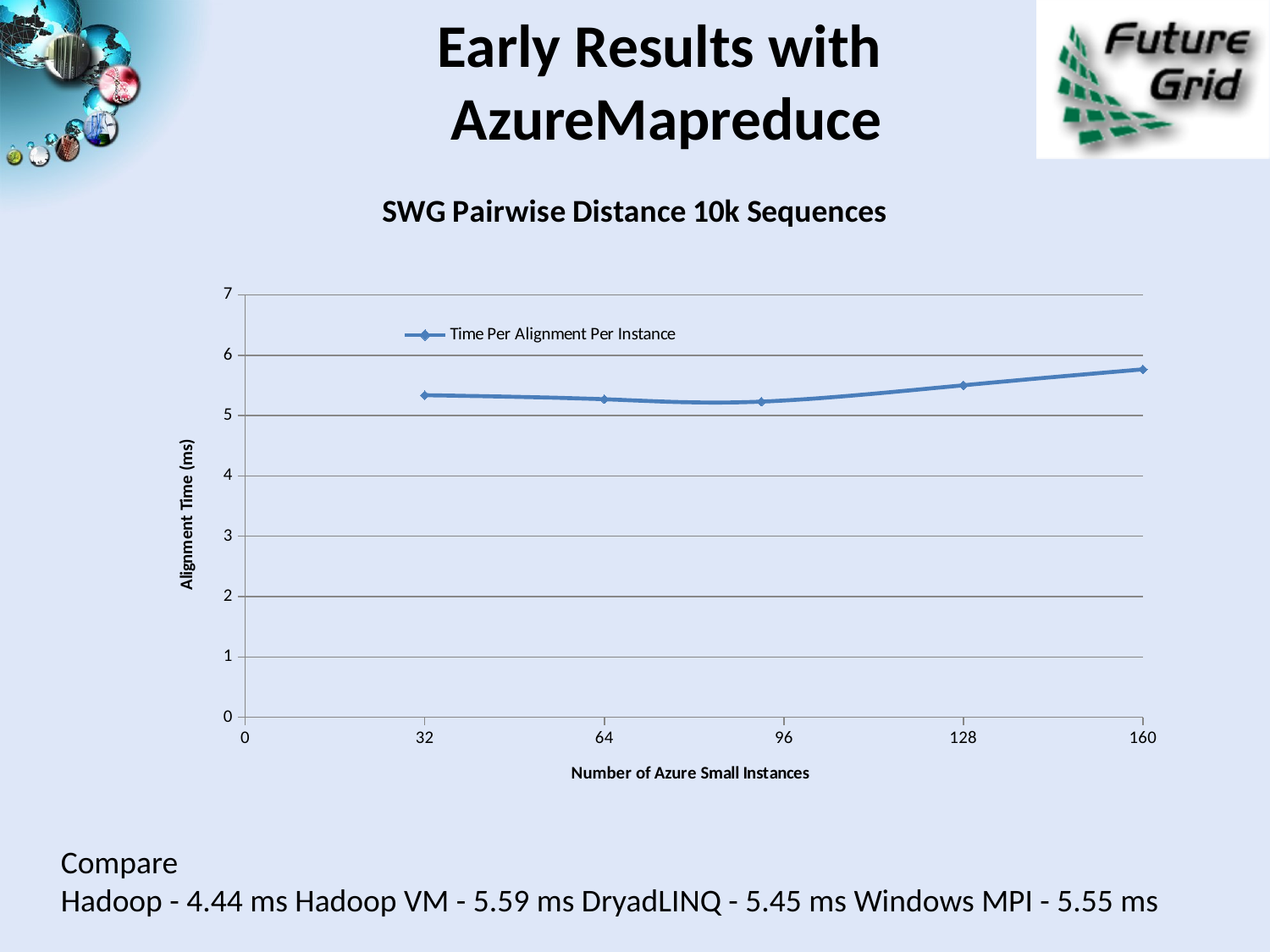
Is the value for Time Per Alignment Per Instance at 128 instances greater or less than 5? greater How many series does the legend list? 1 Does the Time Per Alignment Per Instance rise or fall between 96 and 160 instances? rise What kind of chart is shown on the slide? line chart What is the label of the y axis? Alignment Time (ms) Is the value for Time Per Alignment Per Instance at 32 instances greater or less than 5? greater At which number of Azure Small Instances is the Time Per Alignment Per Instance highest? 160 Which is larger, the Time Per Alignment Per Instance at 128 instances or at 64 instances? 128 instances How many data points are plotted on the line? 5 Is the value for Time Per Alignment Per Instance at 160 instances greater or less than 6? less Which is larger, the Time Per Alignment Per Instance at 160 instances or at 32 instances? 160 instances What is the title of the chart? SWG Pairwise Distance 10k Sequences